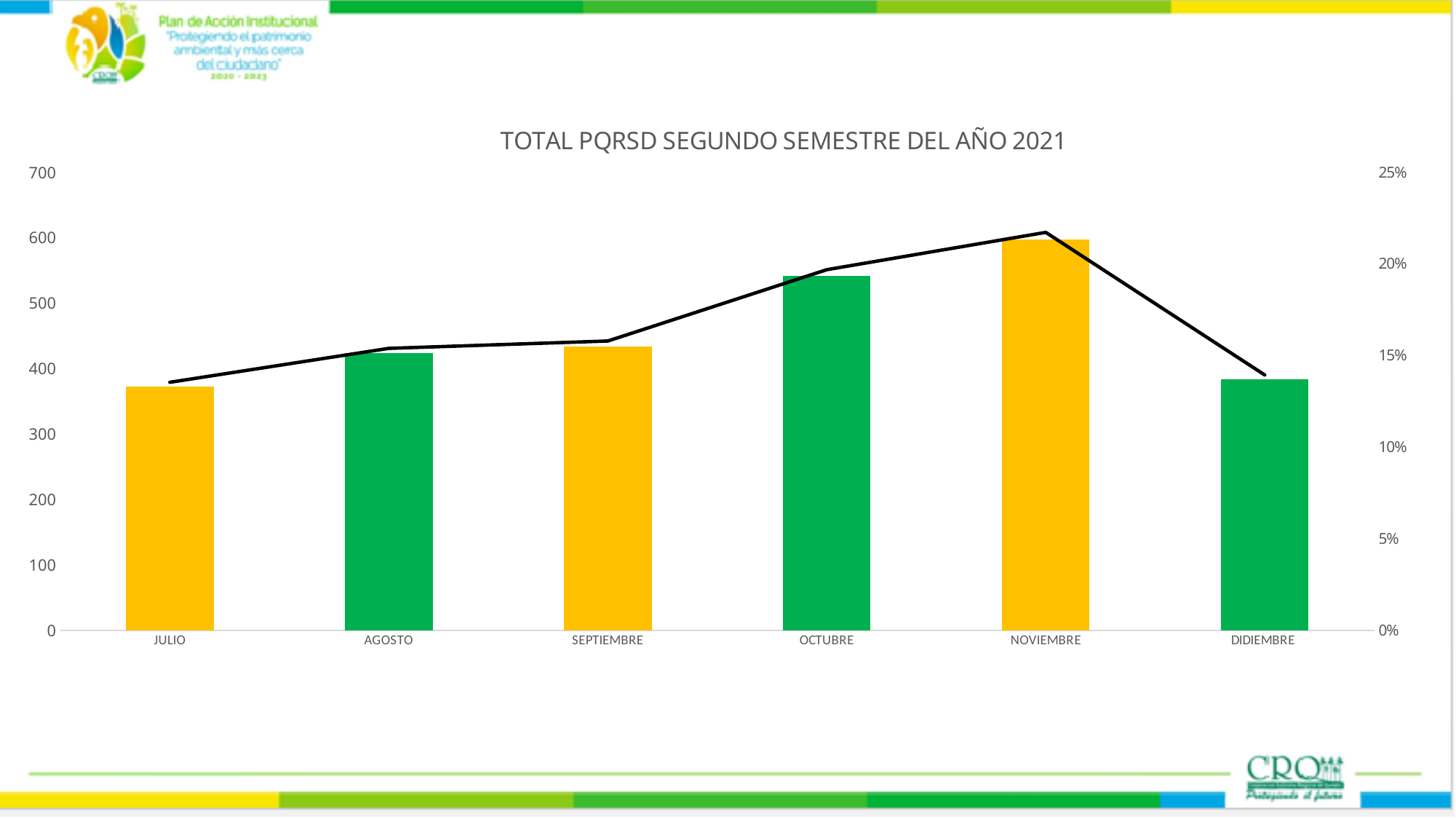
Which month has the lowest bar? JULIO Is the bar value for JULIO greater or less than 400? less Which bar is taller, OCTUBRE or SEPTIEMBRE? OCTUBRE What kind of chart is shown on the slide? A bar chart with a line Which bar is taller, NOVIEMBRE or DIDIEMBRE? NOVIEMBRE Is the bar value for OCTUBRE greater or less than 500? greater Does the line rise or fall from JULIO to NOVIEMBRE? rise How many months are shown on the x axis of the chart? 6 Is the bar value for DIDIEMBRE greater or less than 400? less Which month has the highest bar? NOVIEMBRE What is the title of the chart? TOTAL PQRSD SEGUNDO SEMESTRE DEL AÑO 2021